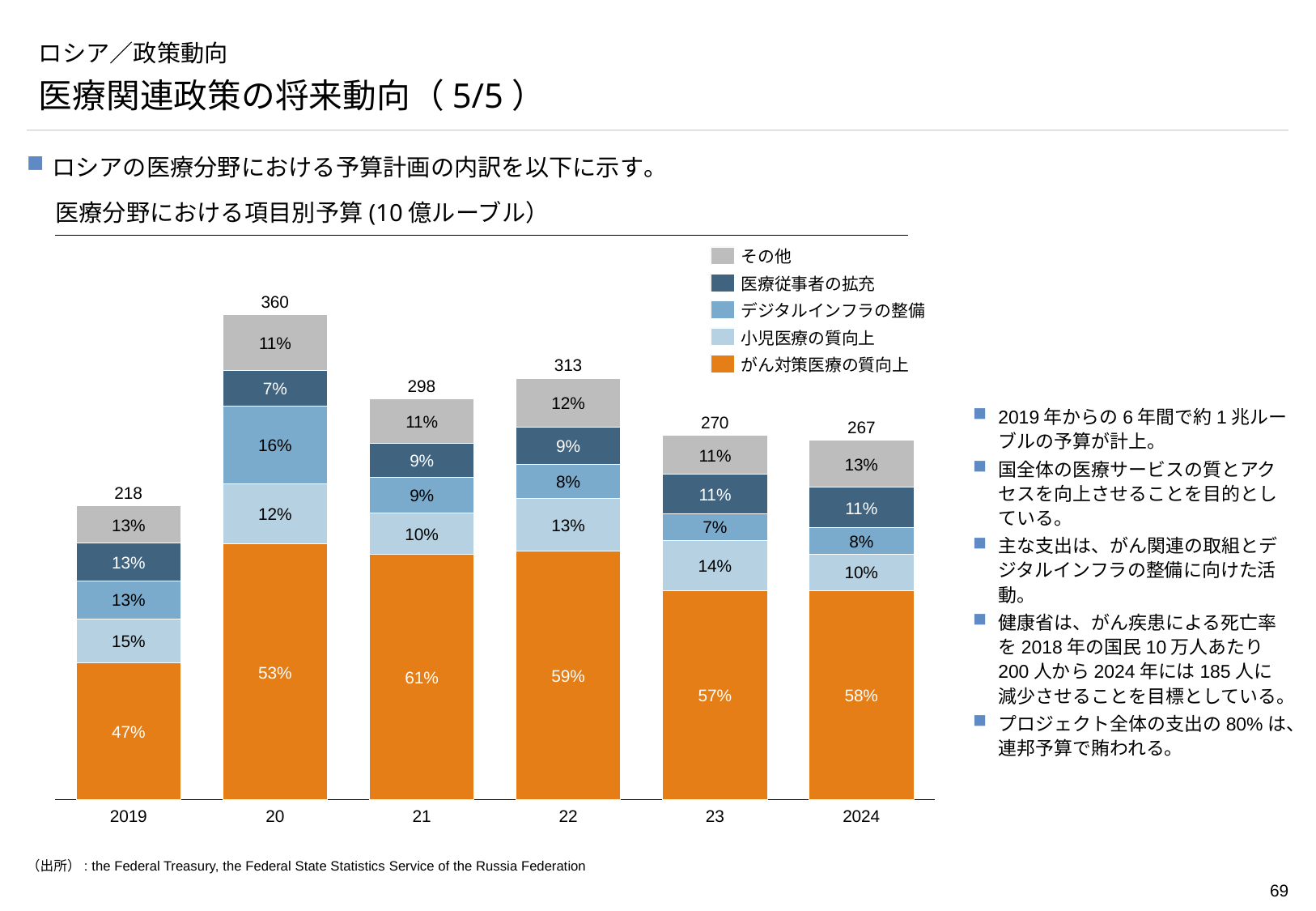
What share of the 2020 budget is for デジタルインフラの整備? 16% What is the total budget shown above the bar for 2019? 218 What share of the 2021 budget is for がん対策医療の質向上? 61% What share of the 2024 budget is for その他? 13% Which year has the lowest total budget? 2019 What type of chart is shown on the slide? Stacked bar chart Which year has the highest total budget? 20 (2020) What unit is stated in the chart title for the budget values? 10億ルーブル What is the difference between the total budgets for 2020 and 2019? 142 How many years (bars) are shown on the x axis? 6 Which is larger, the total budget for 2022 or for 2023? 2022 How many series does the legend list? 5